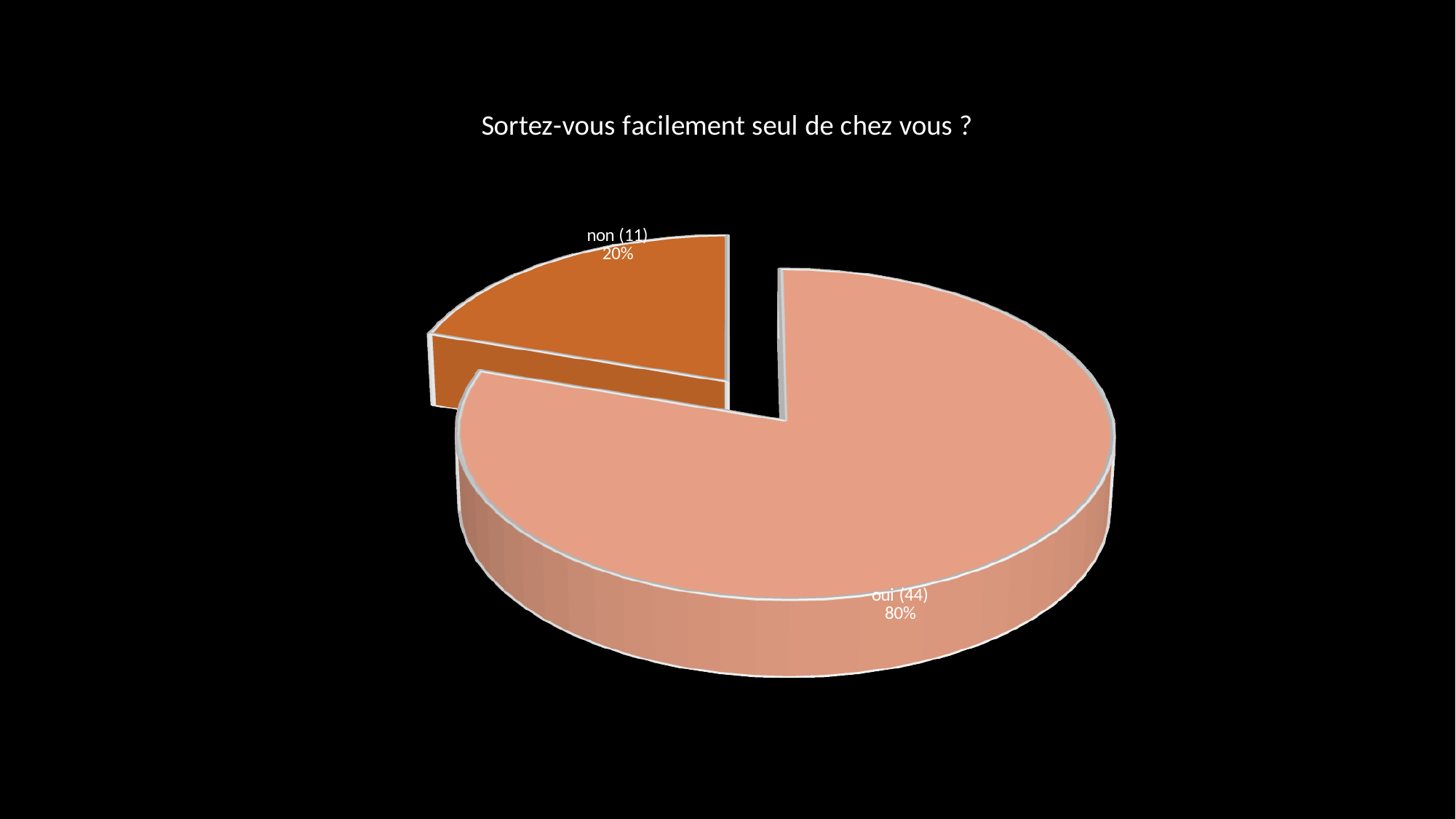
Which slice is the largest? oui Which slice is the smallest? non What is the title of the chart? Sortez-vous facilement seul de chez vous ? What percentage share does the 'non' slice represent? 20% How many respondents answered 'non'? 11 What percentage share does the 'oui' slice represent? 80% What kind of chart is shown on the slide? pie chart How many slices does the pie chart have? 2 What is the difference in respondent count between 'oui' and 'non'? 33 Which has more respondents, 'oui' or 'non'? oui What is the total number of respondents shown in the chart? 55 How many respondents answered 'oui'? 44